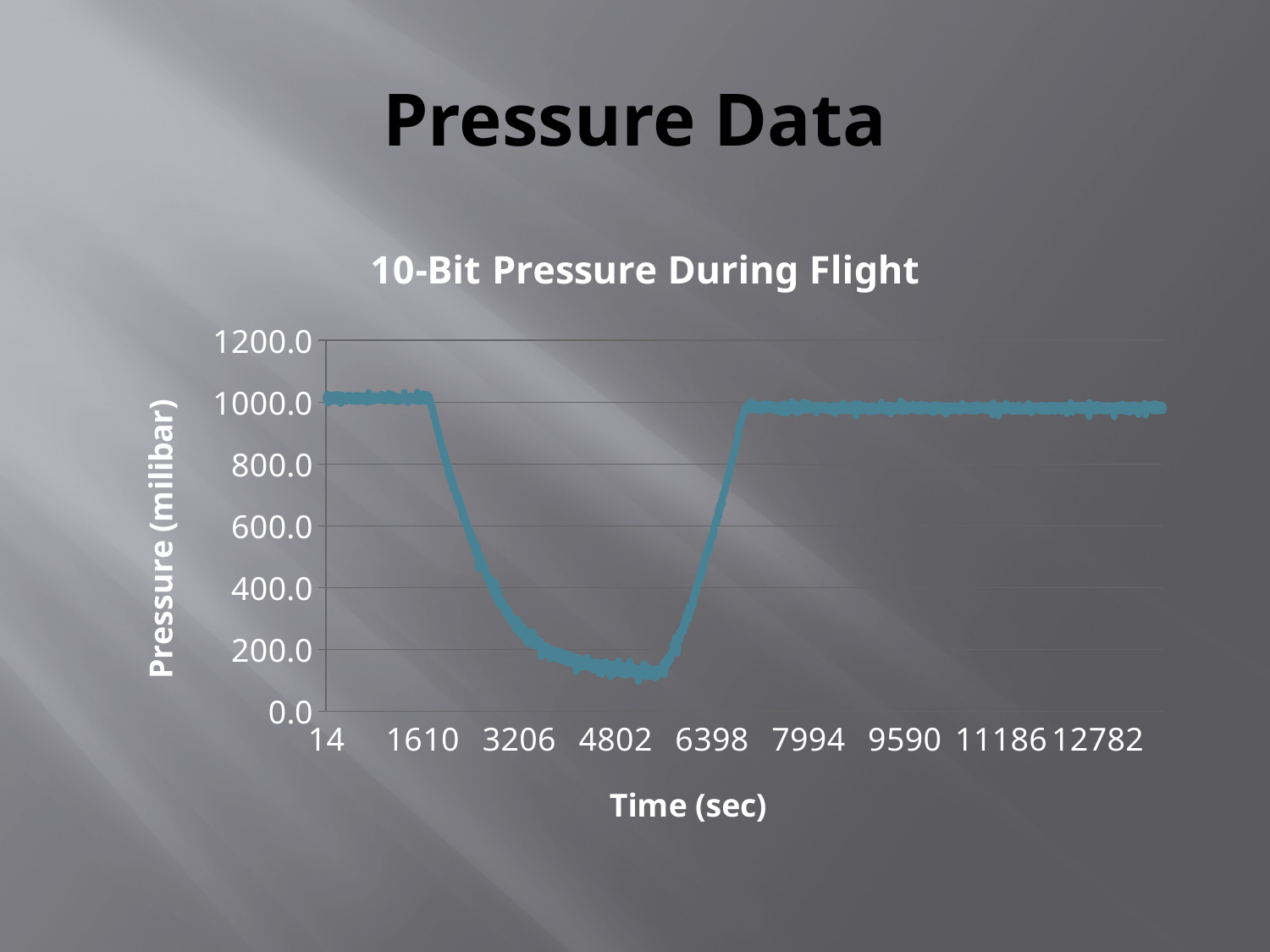
What kind of chart is shown on the slide? line chart What is the label of the y axis? Pressure (milibar) Do the pressure values rise or fall between time 1610 and time 4802? fall What is the highest value shown on the y axis? 1200.0 Is the pressure value at time 3206 greater or less than 600? less Is the pressure at time 4802 larger or smaller than the pressure at time 14? smaller What is the title of the chart? 10-Bit Pressure During Flight How many tick labels are shown on the x axis? 9 Is the pressure value at time 7994 greater or less than 800? greater Is the pressure value at time 14 greater or less than 800? greater Do the pressure values rise or fall between time 6398 and time 7994? rise